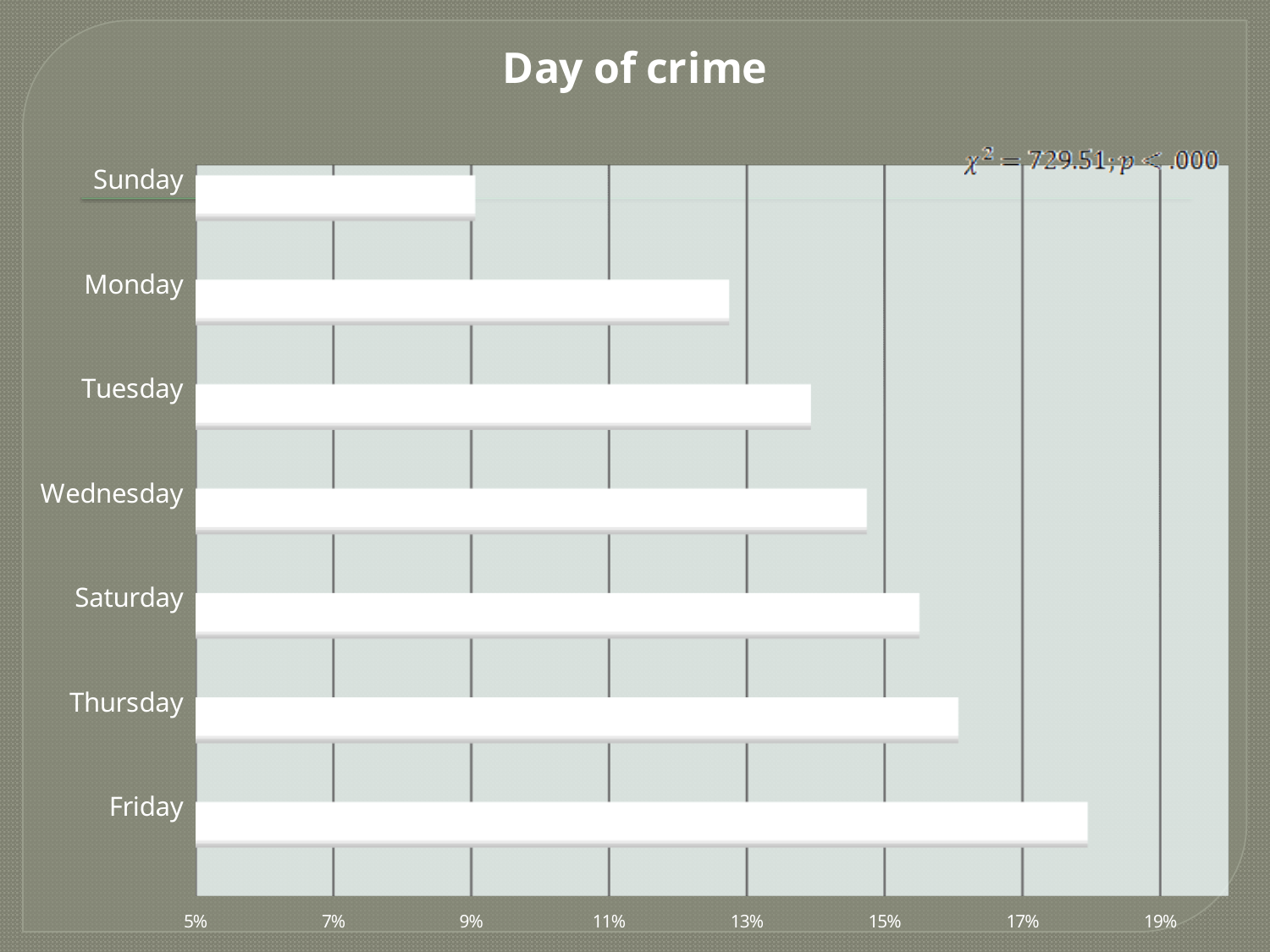
Is the value for Saturday greater or less than 15%? greater Which has the larger value, Thursday or Monday? Thursday Is the value for Wednesday greater or less than 15%? less Is the value for Sunday greater or less than 11%? less How many days are plotted in the chart? 7 Which day has the highest value in the chart? Friday What kind of chart is shown on the slide? bar chart What is the title of the chart? Day of crime Which day has the lowest value in the chart? Sunday Which day is listed at the top of the chart? Sunday